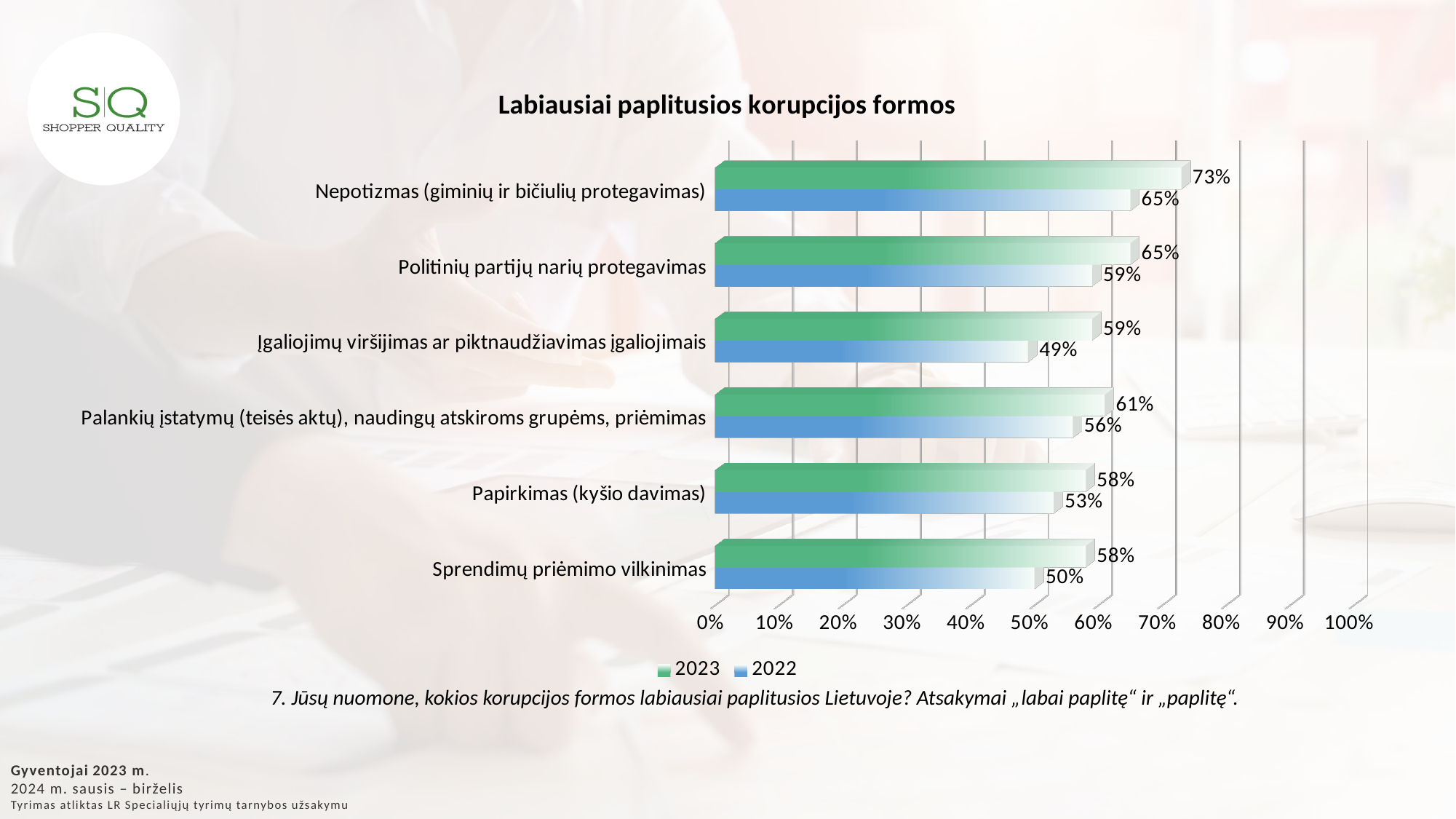
Which category has the highest 2023 value? Nepotizmas (giminių ir bičiulių protegavimas) What kind of chart is shown on the slide? Bar chart What is the title of the chart? Labiausiai paplitusios korupcijos formos What is the 2022 value for Sprendimų priėmimo vilkinimas? 50% What is the difference between the 2023 and 2022 values for Įgaliojimų viršijimas ar piktnaudžiavimas įgaliojimais? 10 percentage points How many categories are shown on the chart? 6 Which is larger: the 2023 value for Papirkimas (kyšio davimas) or the 2023 value for Palankių įstatymų (teisės aktų), naudingų atskiroms grupėms, priėmimas? Palankių įstatymų (teisės aktų), naudingų atskiroms grupėms, priėmimas Which category has the lowest 2022 value? Įgaliojimų viršijimas ar piktnaudžiavimas įgaliojimais What is the difference between the 2023 and 2022 values for Nepotizmas (giminių ir bičiulių protegavimas)? 8 percentage points What is the 2023 value for Nepotizmas (giminių ir bičiulių protegavimas)? 73% What is the 2022 value for Įgaliojimų viršijimas ar piktnaudžiavimas įgaliojimais? 49% How many series does the legend list? 2